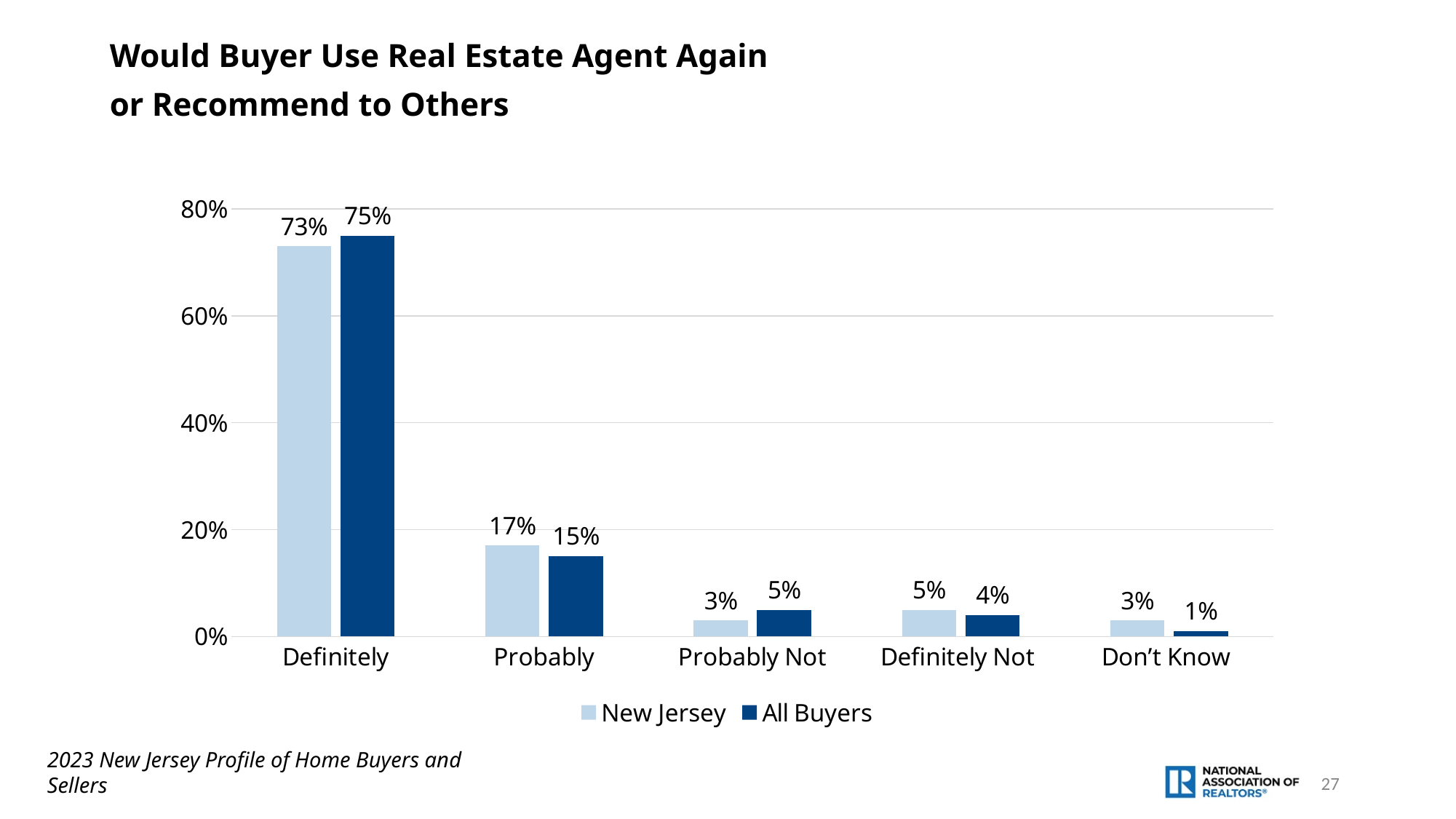
What is the value for All Buyers in the Don't Know category? 1% How many response categories are shown on the x axis? 5 What is the difference between the All Buyers and New Jersey values in the Definitely category? 2% What is the title of the chart? Would Buyer Use Real Estate Agent Again or Recommend to Others How many series does the legend list? 2 Which category has the highest value for All Buyers? Definitely What percentage of New Jersey buyers said they would definitely use their real estate agent again or recommend them? 73% What type of chart is shown on the slide? Bar chart Which category has the lowest value for All Buyers? Don't Know What is the value for All Buyers in the Probably category? 15% In the Probably Not category, which series has the larger value, New Jersey or All Buyers? All Buyers Is the New Jersey value for Definitely greater or less than 60%? greater